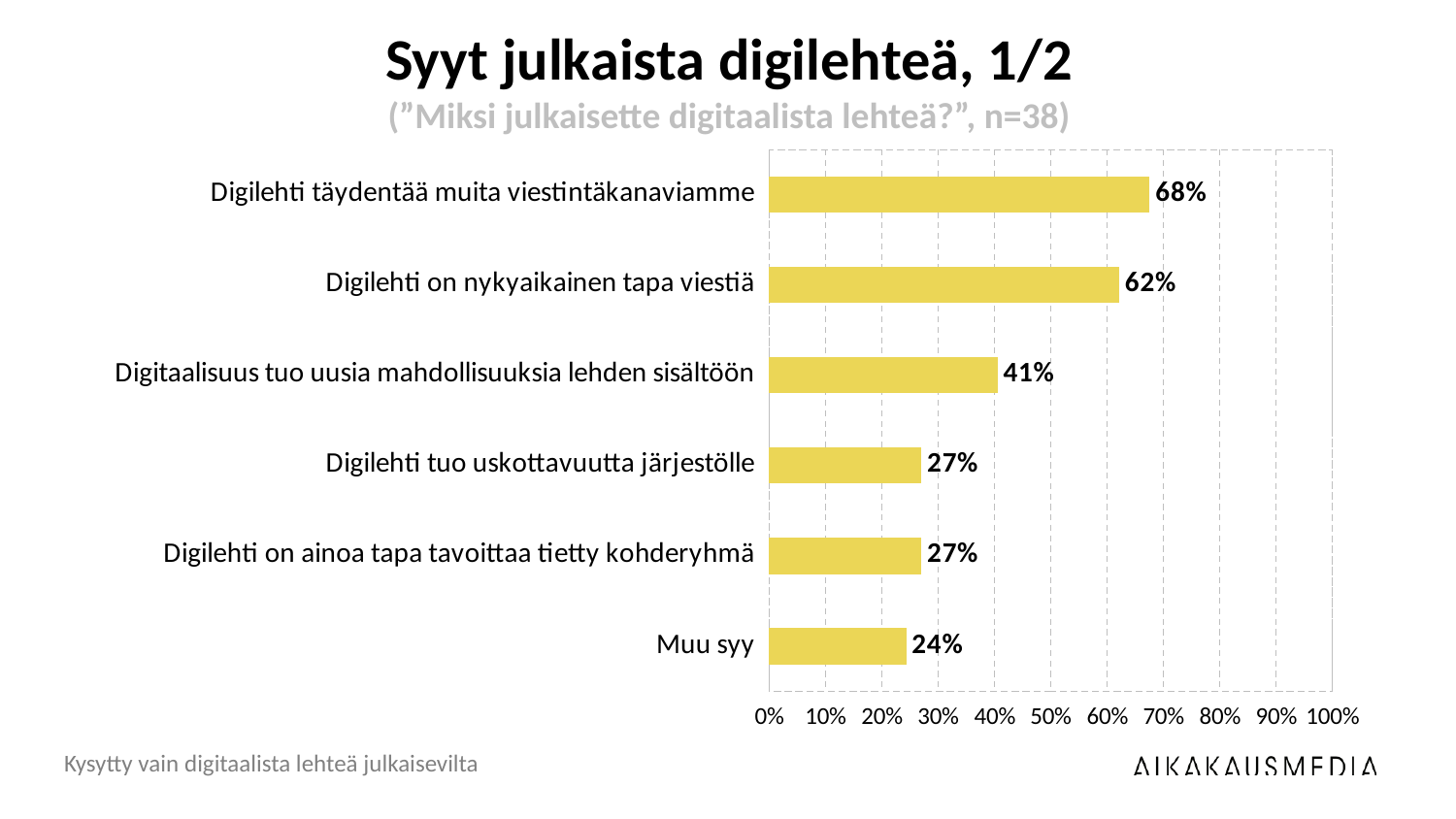
What is the value for "Digilehti täydentää muita viestintäkanaviamme"? 68% What is the value for "Digitaalisuus tuo uusia mahdollisuuksia lehden sisältöön"? 41% How many categories are shown in the chart? 6 What is the difference between "Digitaalisuus tuo uusia mahdollisuuksia lehden sisältöön" and "Muu syy"? 17% Is the value for "Digilehti on ainoa tapa tavoittaa tietty kohderyhmä" greater or less than 30%? less What kind of chart is shown on the slide? Bar chart Which category has the highest value? Digilehti täydentää muita viestintäkanaviamme What is the title of the chart? Syyt julkaista digilehteä, 1/2 Which is larger: "Digilehti on nykyaikainen tapa viestiä" or "Digilehti tuo uskottavuutta järjestölle"? Digilehti on nykyaikainen tapa viestiä What is the value for "Muu syy"? 24% What is the difference between "Digilehti täydentää muita viestintäkanaviamme" and "Digilehti on nykyaikainen tapa viestiä"? 6% Which category has the lowest value? Muu syy